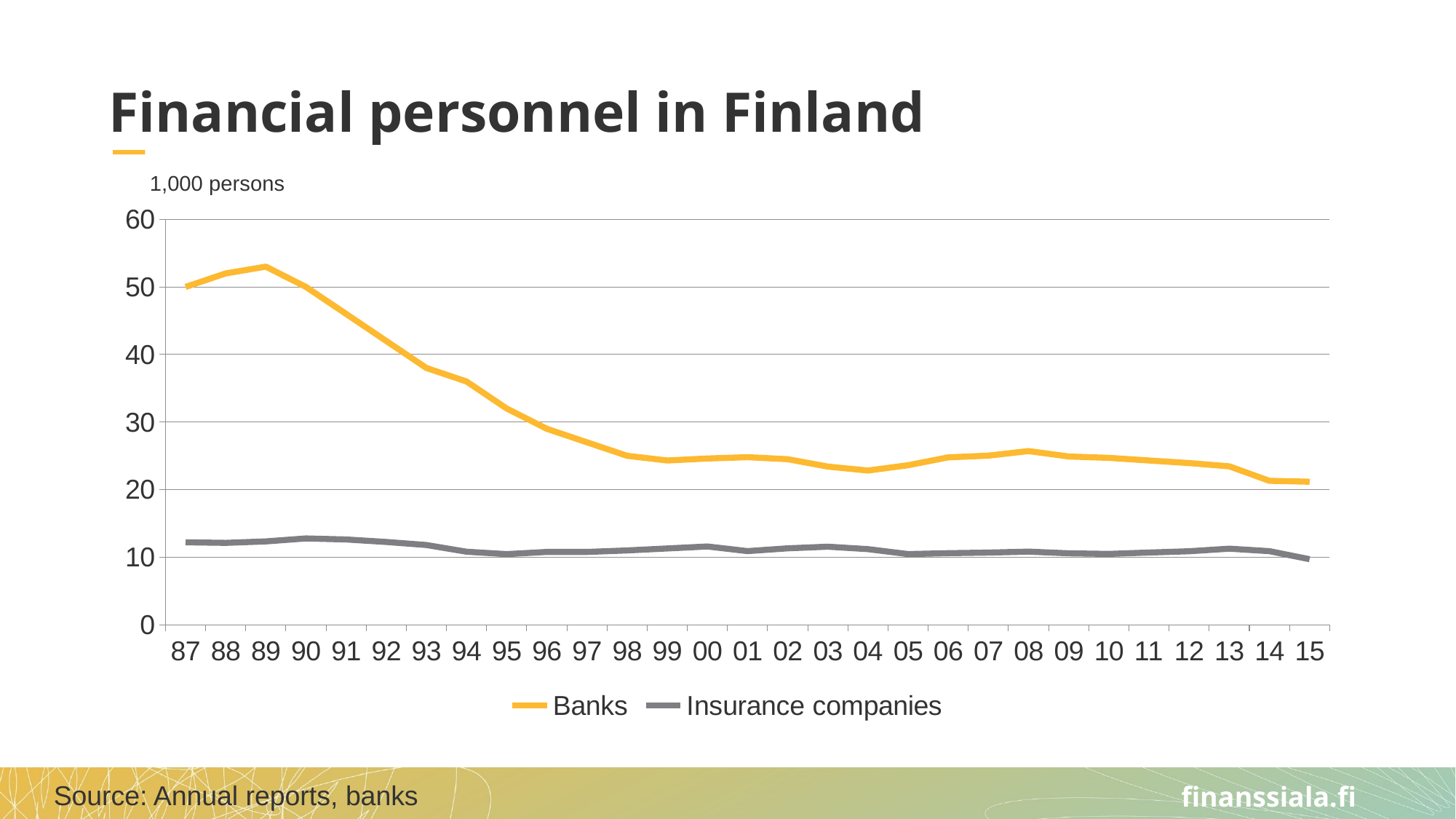
What unit is stated above the y axis? 1,000 persons Does the Banks series rise or fall between 89 and 98? fall In which year does the Insurance companies series reach its highest value? 90 In which year does the Banks series reach its highest value? 89 How many years are plotted along the x axis? 29 What kind of chart is shown on the slide? line chart Is the value for Banks in 89 greater or less than 50? greater Is the value for Banks in 15 greater or less than 30? less Is the value for Insurance companies in 90 greater or less than 10? greater Which series has the larger value in 00, Banks or Insurance companies? Banks How many series does the legend list? 2